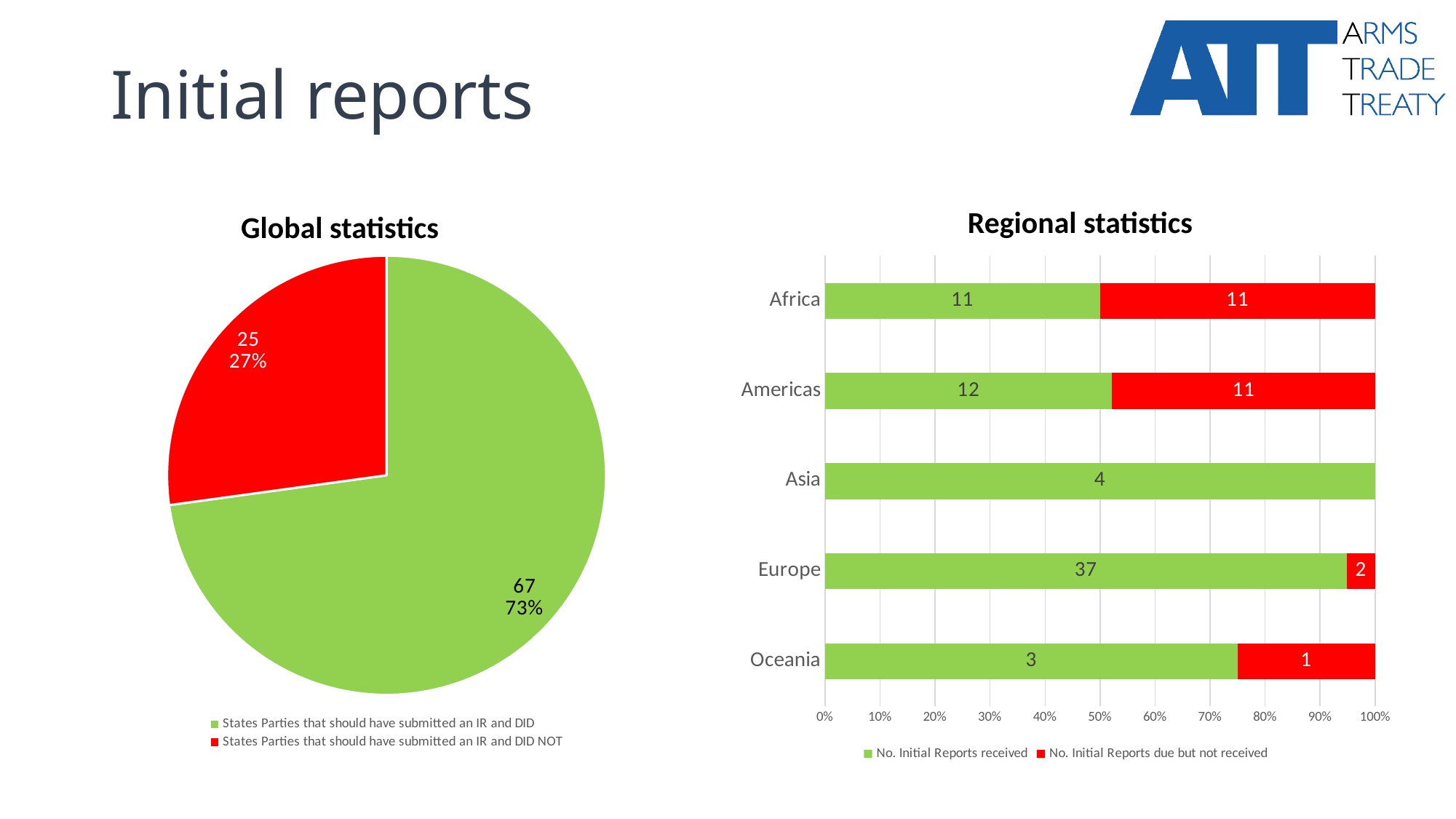
In the Global statistics chart, what kind of chart is shown? pie chart In the Regional statistics chart, which region has the highest number of Initial Reports received? Europe In the Global statistics chart, how many slices does the pie have? 2 In the Regional statistics chart, what kind of chart is shown? bar chart In the Global statistics chart, what share of the pie is States Parties that should have submitted an IR and DID? 73% In the Regional statistics chart, how many Initial Reports were due but not received for Oceania? 1 In the Regional statistics chart, how many series does the legend list? 2 In the Regional statistics chart, how many regions are listed? 5 In the Regional statistics chart, what is the difference between Initial Reports received and due but not received for Europe? 35 In the Regional statistics chart, how many Initial Reports were received for Europe? 37 In the Regional statistics chart, what is the total number of Initial Reports (received plus due but not received) for Americas? 23 In the Global statistics chart, how many States Parties that should have submitted an IR DID NOT? 25